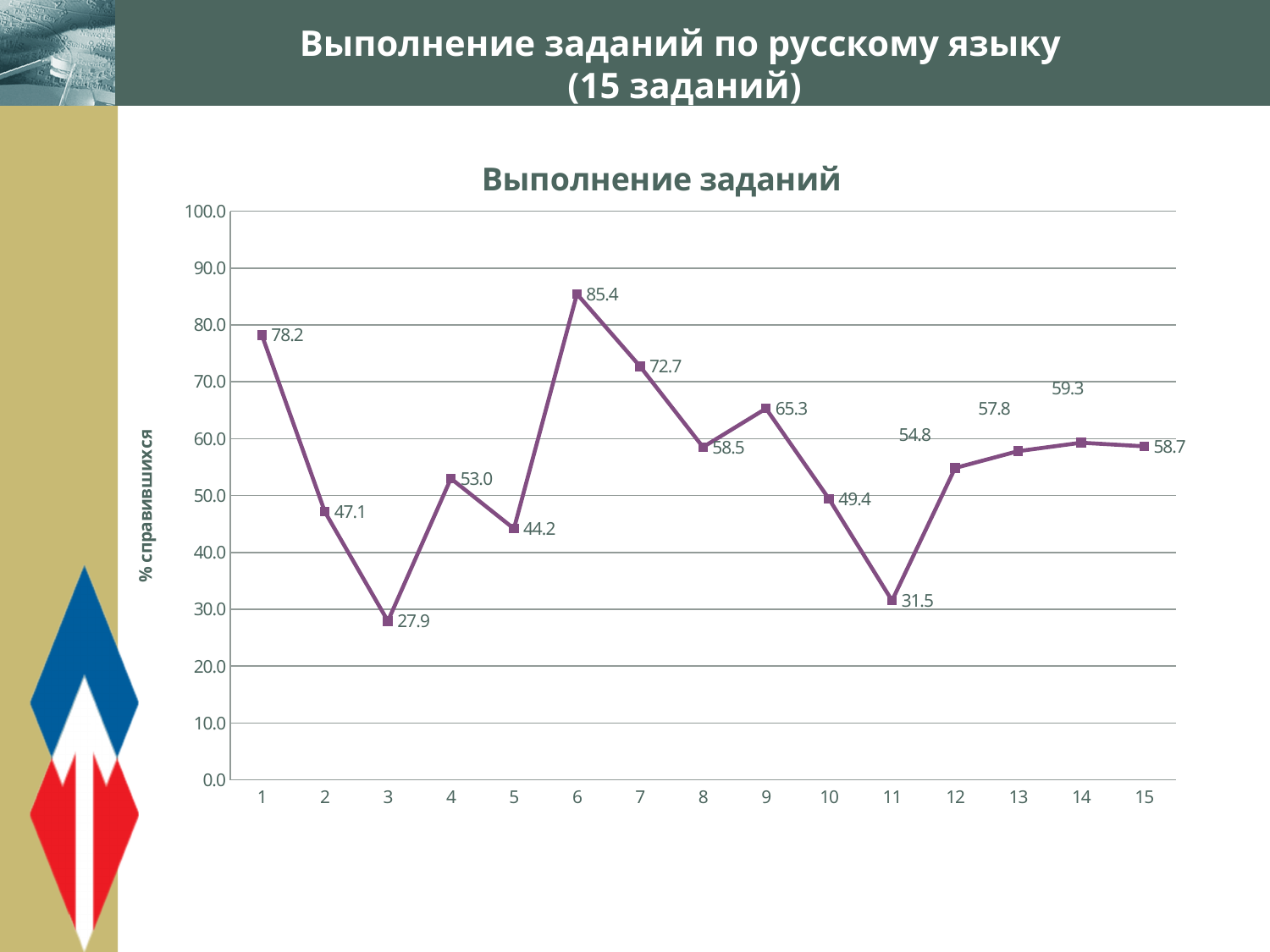
What is the value for task 15? 58.7 Which is larger, the value for task 7 or the value for task 9? task 7 What is the value for task 11? 31.5 Which task has the highest value? 6 What kind of chart is shown? line chart Which task has the lowest value? 3 Is the value for task 10 greater or less than 50.0? less What is the difference between the values for task 1 and task 2? 31.1 What is the title of the chart? Выполнение заданий How many tasks are plotted on the x axis? 15 What is the value for task 6? 85.4 What is the difference between the values for task 6 and task 3? 57.5